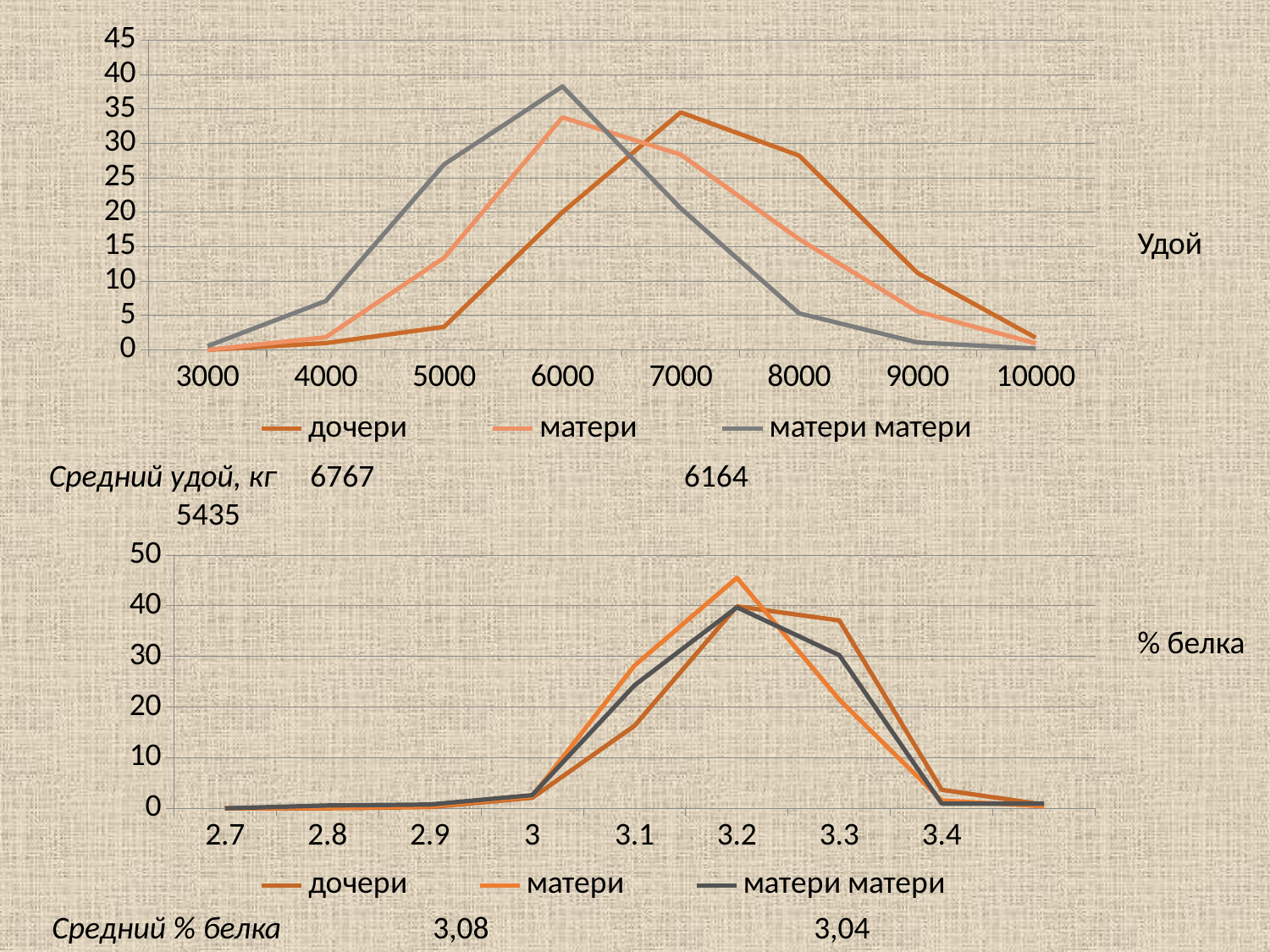
In the top chart (Удой), is the value for матери матери at 6000 greater or less than 35? greater In the bottom chart (% белка), is the value for матери at 3.2 greater or less than 40? greater What are the legend entries of the bottom chart (% белка)? дочери, матери, матери матери In the top chart (Удой), is the value for матери матери at 5000 greater or less than 20? greater In the top chart (Удой), which series reaches the highest peak value? матери матери What kind of chart is the top chart (Удой)? line chart In the bottom chart (% белка), which series reaches the highest peak value? матери How many series does the legend of the top chart (Удой) list? 3 How many x-axis categories are labelled on the top chart (Удой)? 8 In the top chart (Удой), do the values for дочери rise or fall from 7000 to 10000? fall